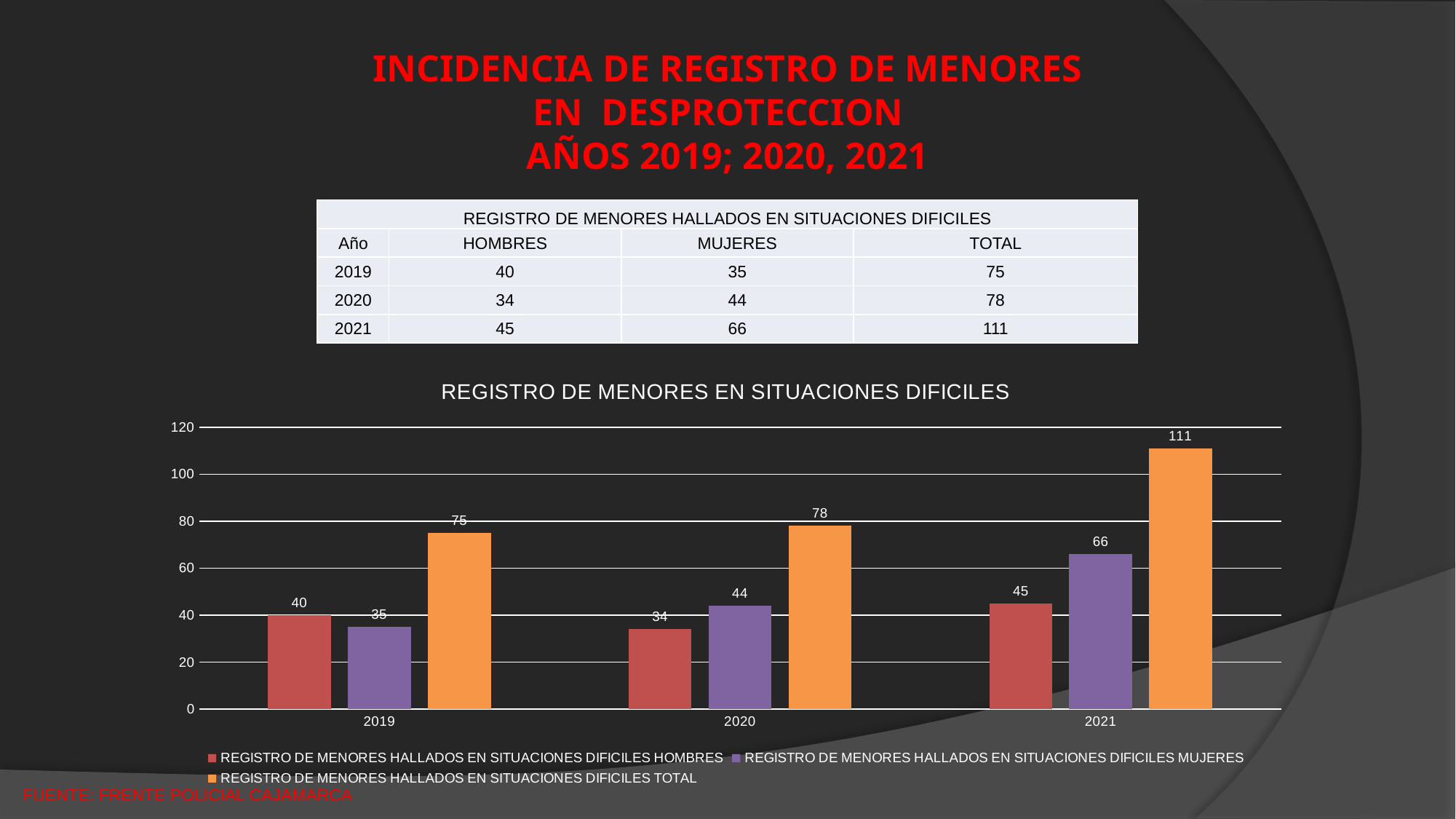
Does the TOTAL value rise or fall from 2019 to 2021? Rise What is the title of the chart? REGISTRO DE MENORES EN SITUACIONES DIFICILES Which year has the highest TOTAL value? 2021 How many years are shown on the x axis of the chart? 3 Which is larger in 2020, the HOMBRES value or the MUJERES value? MUJERES What is the value for MUJERES in 2021? 66 What is the difference between the MUJERES values for 2021 and 2019? 31 What is the value for HOMBRES in 2019? 40 What is the TOTAL value for 2020? 78 What kind of chart is shown on the slide? Bar chart Which year has the lowest value for HOMBRES? 2020 How many series does the chart legend list? 3